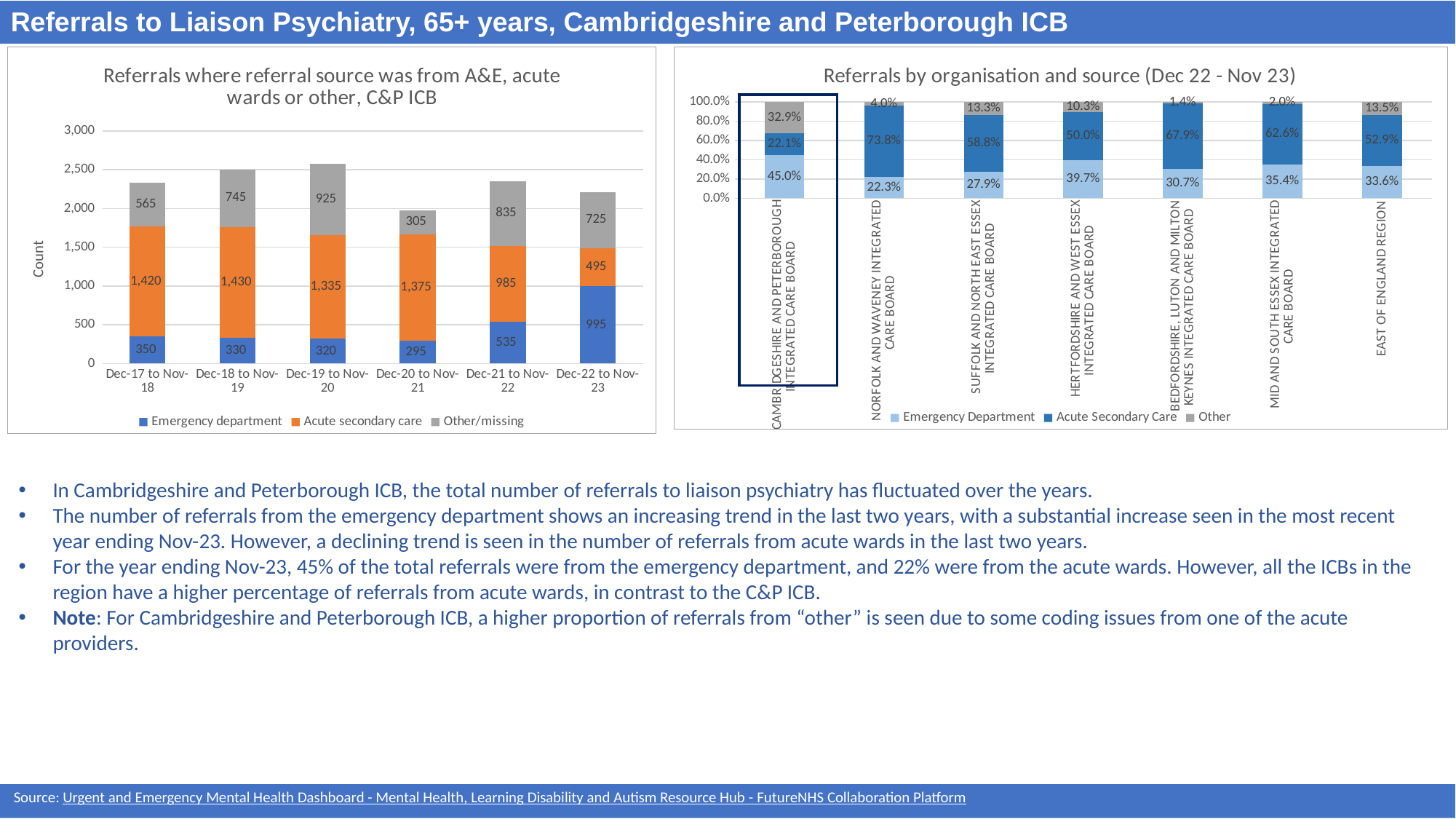
In the left chart, what is the Emergency department value for Dec-22 to Nov-23? 995 In the right chart, which organisation has the lowest Other percentage? Bedfordshire, Luton and Milton Keynes Integrated Care Board In the left chart, which period has the highest Other/missing value? Dec-19 to Nov-20 In the left chart, what is the Acute secondary care value for Dec-18 to Nov-19? 1,430 In the right chart, what is the Acute Secondary Care percentage for Norfolk and Waveney Integrated Care Board? 73.8% In the left chart, how many periods are shown on the x axis? 6 In the left chart, what is the total of the stacked bar for Dec-20 to Nov-21? 1,975 In the left chart, what is the difference between the Acute secondary care values for Dec-21 to Nov-22 and Dec-22 to Nov-23? 490 In the left chart, which period has the lowest Emergency department value? Dec-20 to Nov-21 In the right chart, is the Emergency Department percentage larger for Hertfordshire and West Essex Integrated Care Board or for Suffolk and North East Essex Integrated Care Board? Hertfordshire and West Essex Integrated Care Board How many series does the legend of the right chart list? 3 In the right chart, which organisation has the highest Emergency Department percentage? Cambridgeshire and Peterborough Integrated Care Board